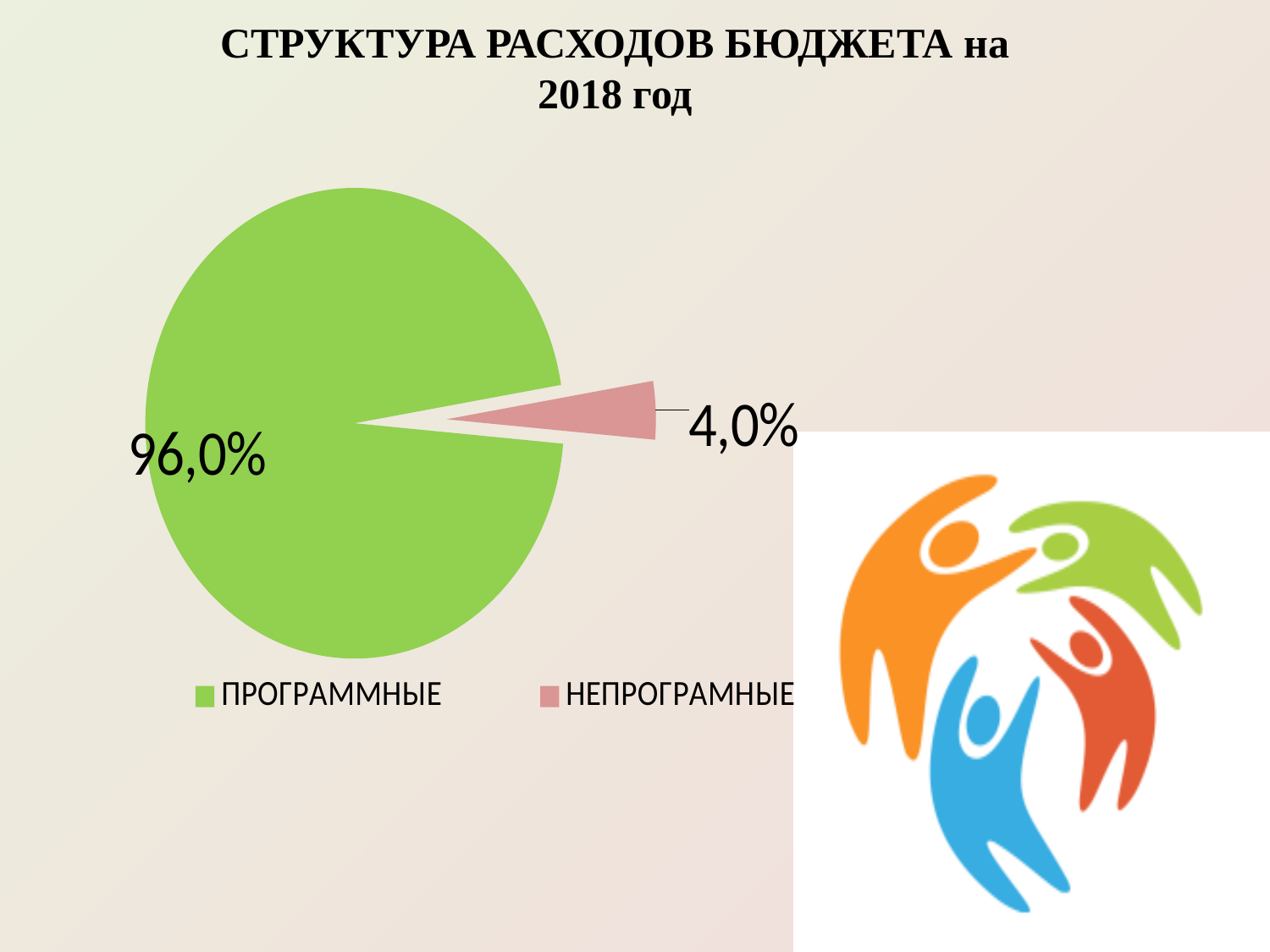
What colour is the slice for НЕПРОГРАМНЫЕ? pink What share of the pie does ПРОГРАММНЫЕ take? 96,0% What kind of chart is shown on the slide? pie chart What is the value for ПРОГРАММНЫЕ? 96,0% What is the title of the chart? СТРУКТУРА РАСХОДОВ БЮДЖЕТА на 2018 год How many entries does the legend list? 2 Which category has the smallest share of the pie? НЕПРОГРАМНЫЕ How many slices does the pie chart have? 2 What is the value for НЕПРОГРАМНЫЕ? 4,0% Which is larger, the share of ПРОГРАММНЫЕ or the share of НЕПРОГРАМНЫЕ? ПРОГРАММНЫЕ Which category has the largest share of the pie? ПРОГРАММНЫЕ What is the difference between the shares of ПРОГРАММНЫЕ and НЕПРОГРАМНЫЕ? 92,0%